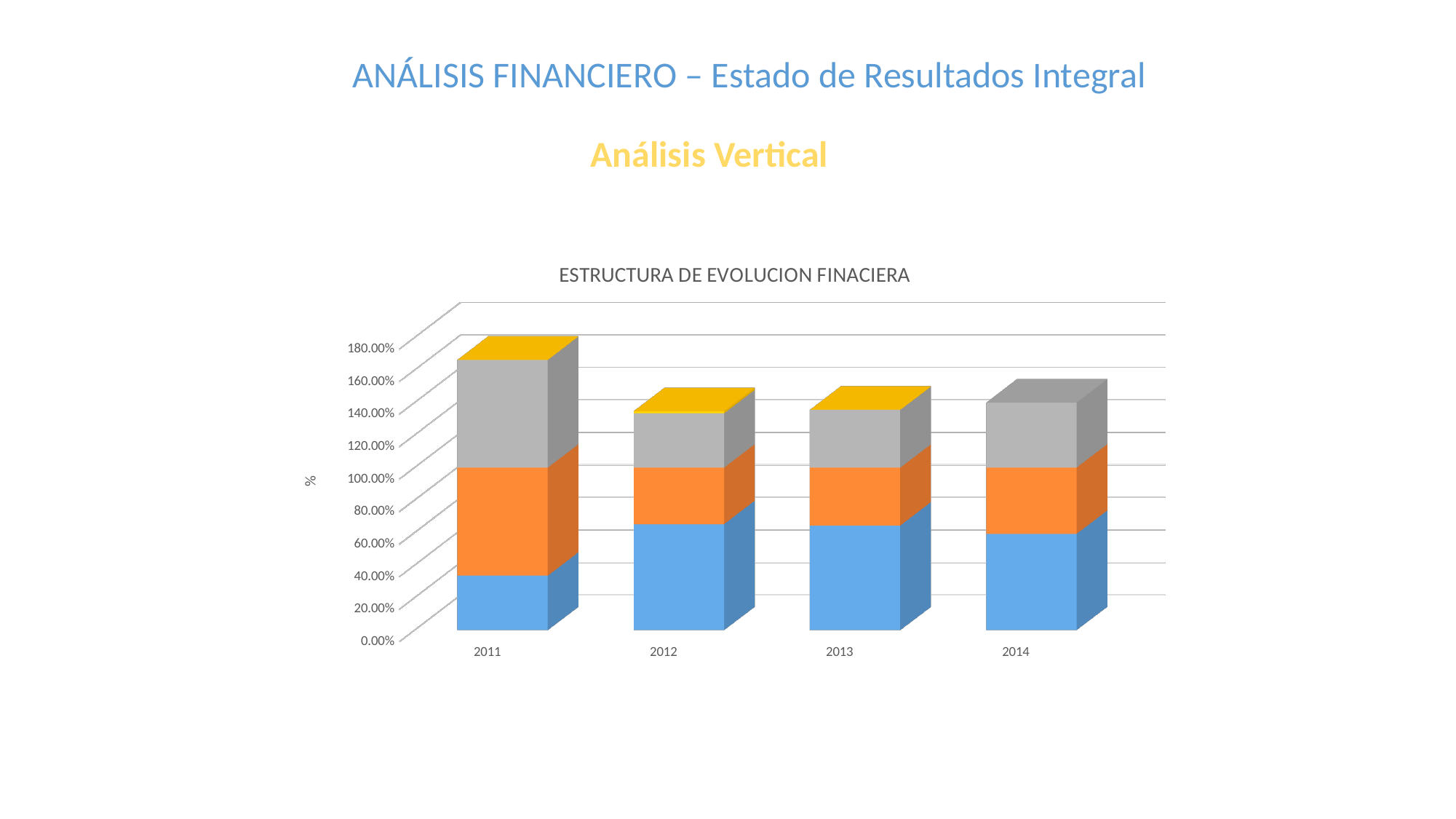
Is the blue segment for 2011 greater or less than 60.00%? less Is the total height of the 2011 bar greater or less than 160.00%? greater Is the total height of the 2014 bar greater or less than 160.00%? less Which year has the largest orange segment? 2011 Which year has the smallest blue segment? 2011 What is the title of the chart? ESTRUCTURA DE EVOLUCION FINACIERA Which is larger, the orange segment for 2011 or the orange segment for 2012? 2011 What kind of chart is shown on the slide? Stacked bar chart Which year's bar has no yellow segment on top? 2014 Which year has the tallest stacked bar overall? 2011 How many years are shown on the x axis of the chart? 4